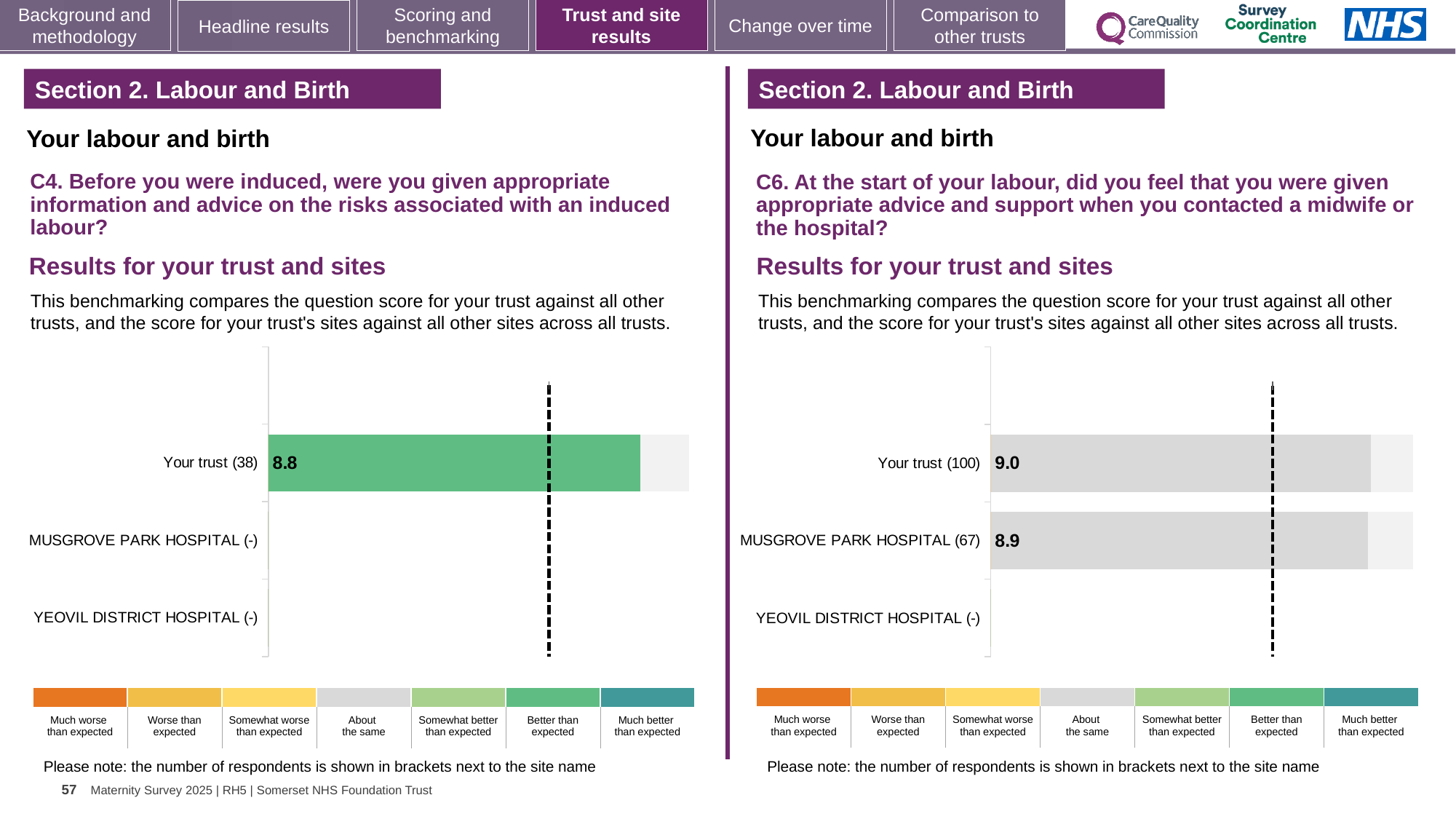
How many categories are listed on the vertical axis of the C6 chart on the right? 3 In the C6 chart on the right, what is the score for Your trust (100)? 9.0 In the C6 chart on the right, what is the score for MUSGROVE PARK HOSPITAL (67)? 8.9 What kind of chart is the C4 chart on the left? Bar chart In the C4 chart on the left, how many respondents are shown in brackets for Your trust? 38 How many categories are listed on the vertical axis of the C4 chart on the left? 3 In the C6 chart on the right, which has the higher score: Your trust (100) or MUSGROVE PARK HOSPITAL (67)? Your trust (100) In the C6 chart on the right, what is the difference between the scores for Your trust (100) and MUSGROVE PARK HOSPITAL (67)? 0.1 In the C6 chart on the right, which benchmark category does the grey colour of the bars correspond to in the legend? About the same In the C4 chart on the left, what is the score for Your trust (38)? 8.8 In the C4 chart on the left, which benchmark category does the green colour of the Your trust bar correspond to in the legend? Better than expected In the C6 chart on the right, which category has the highest score? Your trust (100)